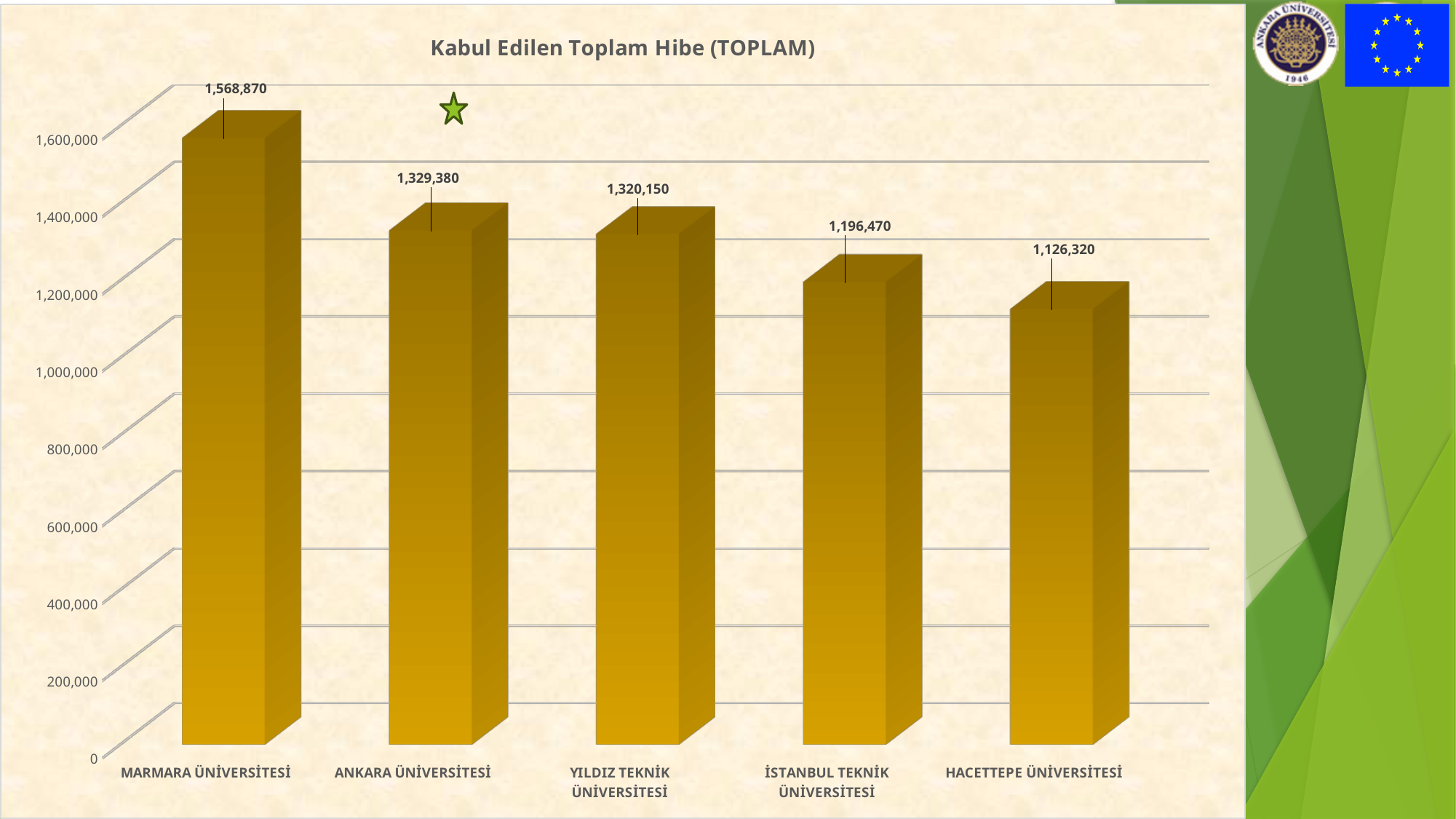
What is the difference between the values for MARMARA ÜNİVERSİTESİ and HACETTEPE ÜNİVERSİTESİ? 442,550 What is the value for MARMARA ÜNİVERSİTESİ? 1,568,870 What kind of chart is shown on the slide? bar chart How many universities are shown on the chart? 5 What is the value for HACETTEPE ÜNİVERSİTESİ? 1,126,320 Which university has the highest value? MARMARA ÜNİVERSİTESİ What is the title of the chart? Kabul Edilen Toplam Hibe (TOPLAM) Which is larger, the value for ANKARA ÜNİVERSİTESİ or the value for İSTANBUL TEKNİK ÜNİVERSİTESİ? ANKARA ÜNİVERSİTESİ What is the value for İSTANBUL TEKNİK ÜNİVERSİTESİ? 1,196,470 Is the value for YILDIZ TEKNİK ÜNİVERSİTESİ greater or less than 1,400,000? less Which university has the lowest value? HACETTEPE ÜNİVERSİTESİ What is the difference between the values for ANKARA ÜNİVERSİTESİ and YILDIZ TEKNİK ÜNİVERSİTESİ? 9,230